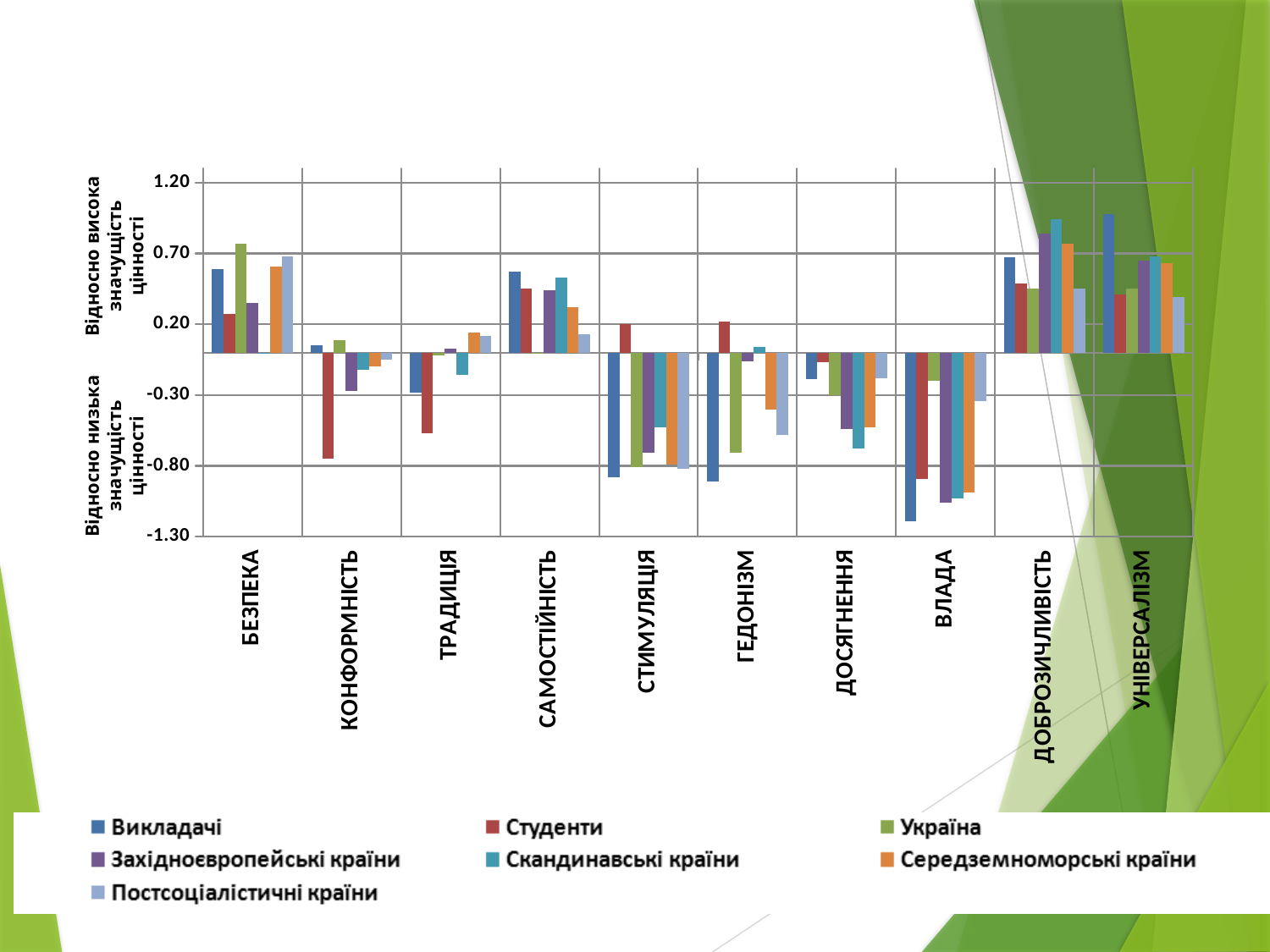
How many categories are shown along the x axis of the chart? 10 Is the value for Студенти in КОНФОРМНІСТЬ greater or less than -0.30? less Which series has the highest value for УНІВЕРСАЛІЗМ? Викладачі What kind of chart is shown on the slide? bar chart Which series has the lowest value for ВЛАДА? Викладачі Is the value for Викладачі in ВЛАДА greater or less than -0.80? less Which series has the highest value for ДОБРОЗИЧЛИВІСТЬ? Скандинавські країни Is the value for Викладачі in УНІВЕРСАЛІЗМ greater or less than 0.70? greater Which series has the highest value for БЕЗПЕКА? Україна For БЕЗПЕКА, which is larger: the value for Викладачі or the value for Студенти? Викладачі How many series does the legend of the chart list? 7 For ГЕДОНІЗМ, which is larger: the value for Студенти or the value for Викладачі? Студенти